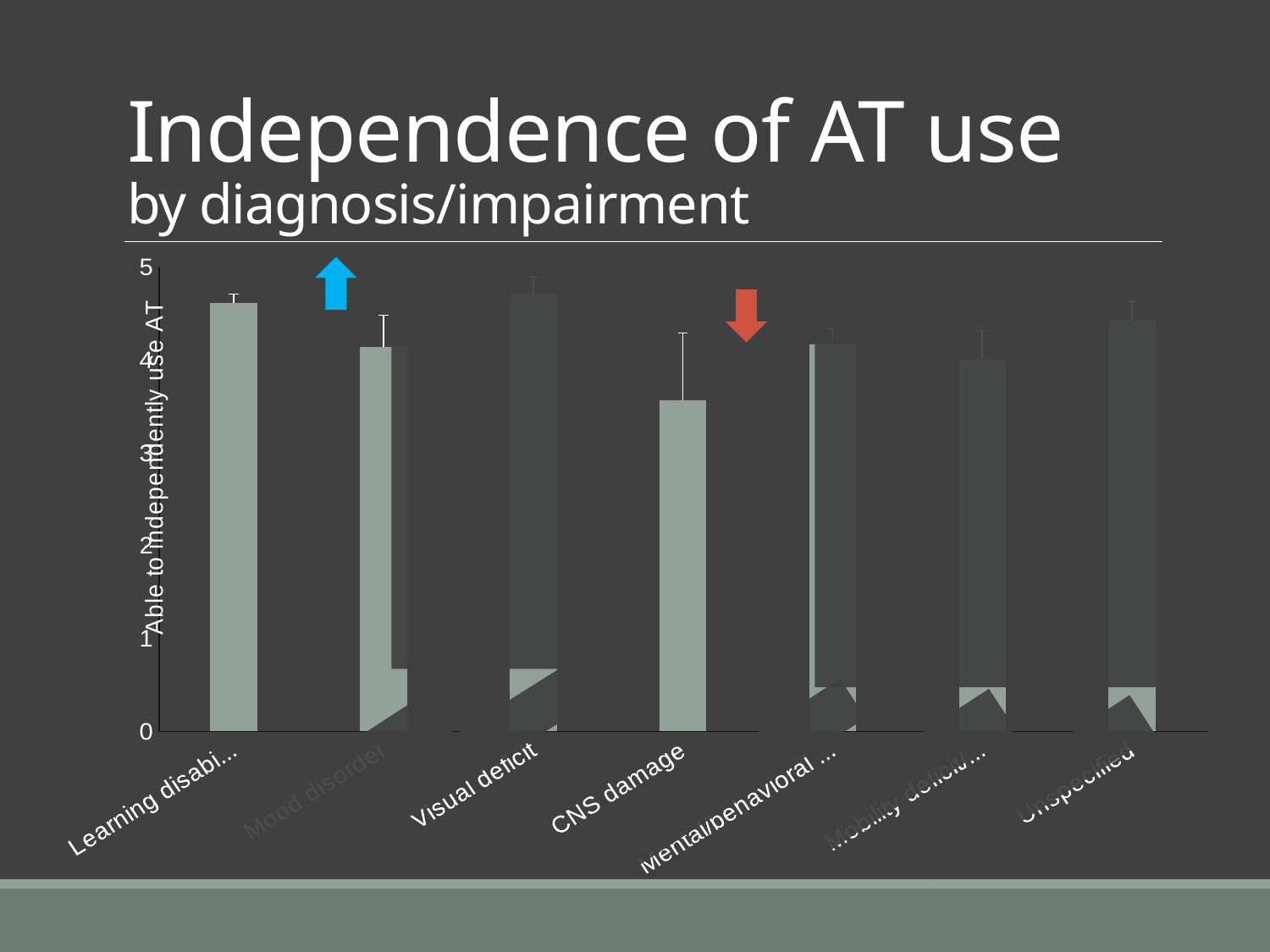
Which is larger, the value for Visual deficit or the value for CNS damage? Visual deficit What is the maximum value shown on the vertical axis? 5 Is the value for Visual deficit greater or less than 4? greater How many diagnosis/impairment categories are plotted on the chart? 7 Is the value for Unspecified greater or less than 4? greater Which is larger, the value for Learning disability or the value for Mood disorder? Learning disability What is the label on the vertical axis of the chart? Able to independently use AT Is the value for CNS damage greater or less than 4? less What kind of chart is shown on the slide? bar chart Which category has the lowest value for ability to independently use AT? CNS damage What is the title of the chart on the slide? Independence of AT use by diagnosis/impairment